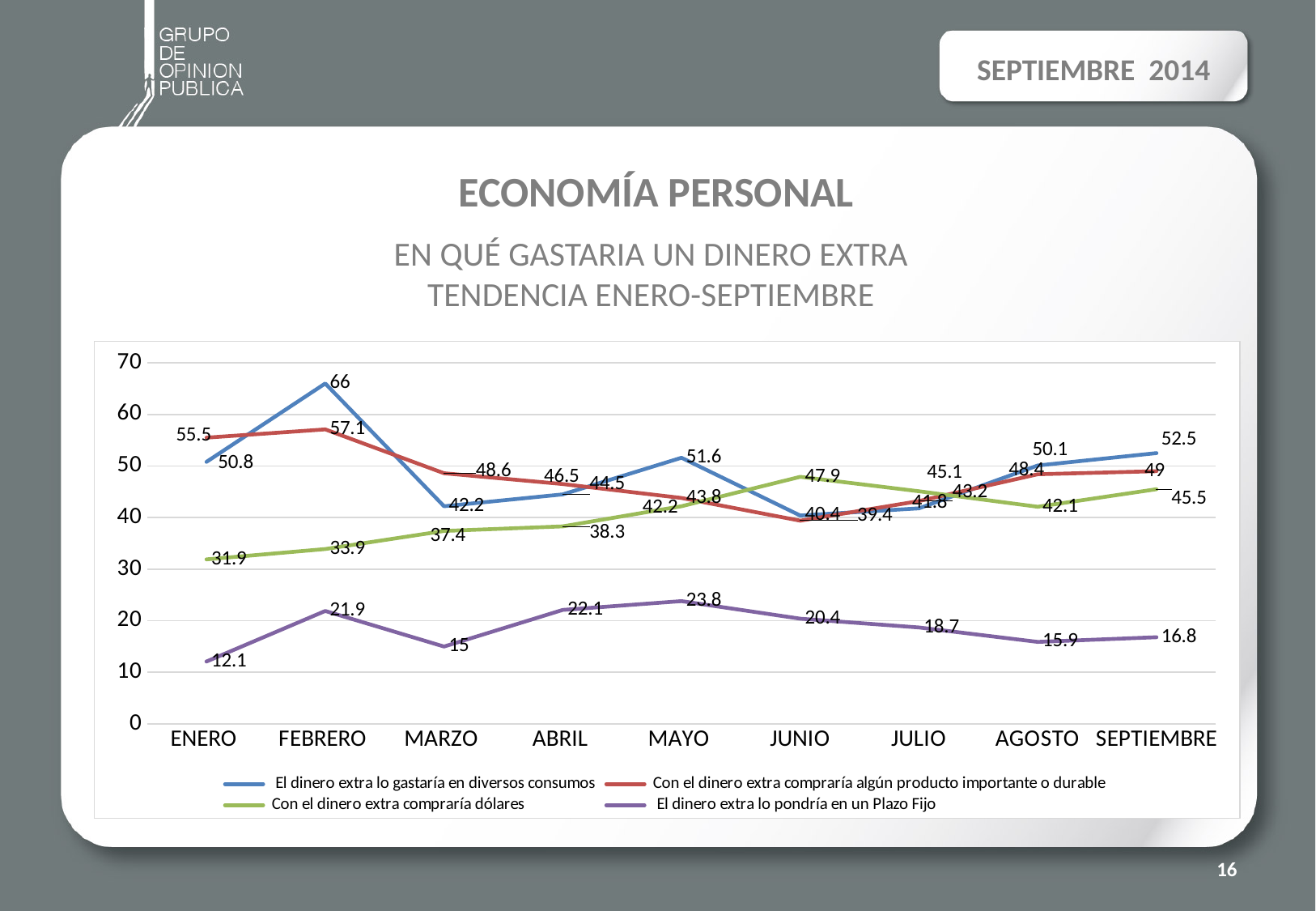
What is the value for 'El dinero extra lo gastaría en diversos consumos' in FEBRERO? 66 What is the value for 'Con el dinero extra compraría dólares' in JUNIO? 47.9 In which month is 'El dinero extra lo pondría en un Plazo Fijo' at its lowest value? ENERO Does 'Con el dinero extra compraría dólares' generally rise or fall from ENERO to JUNIO? rise How many series does the legend list? 4 What is the value for 'Con el dinero extra compraría algún producto importante o durable' in SEPTIEMBRE? 49 What kind of chart is shown on the slide? line chart What is the value for 'El dinero extra lo pondría en un Plazo Fijo' in ENERO? 12.1 Which is larger in ENERO: 'Con el dinero extra compraría algún producto importante o durable' or 'El dinero extra lo gastaría en diversos consumos'? Con el dinero extra compraría algún producto importante o durable How many months are shown on the x axis? 9 In which month does 'El dinero extra lo gastaría en diversos consumos' reach its highest value? FEBRERO What is the difference between the SEPTIEMBRE and ENERO values for 'Con el dinero extra compraría dólares'? 13.6